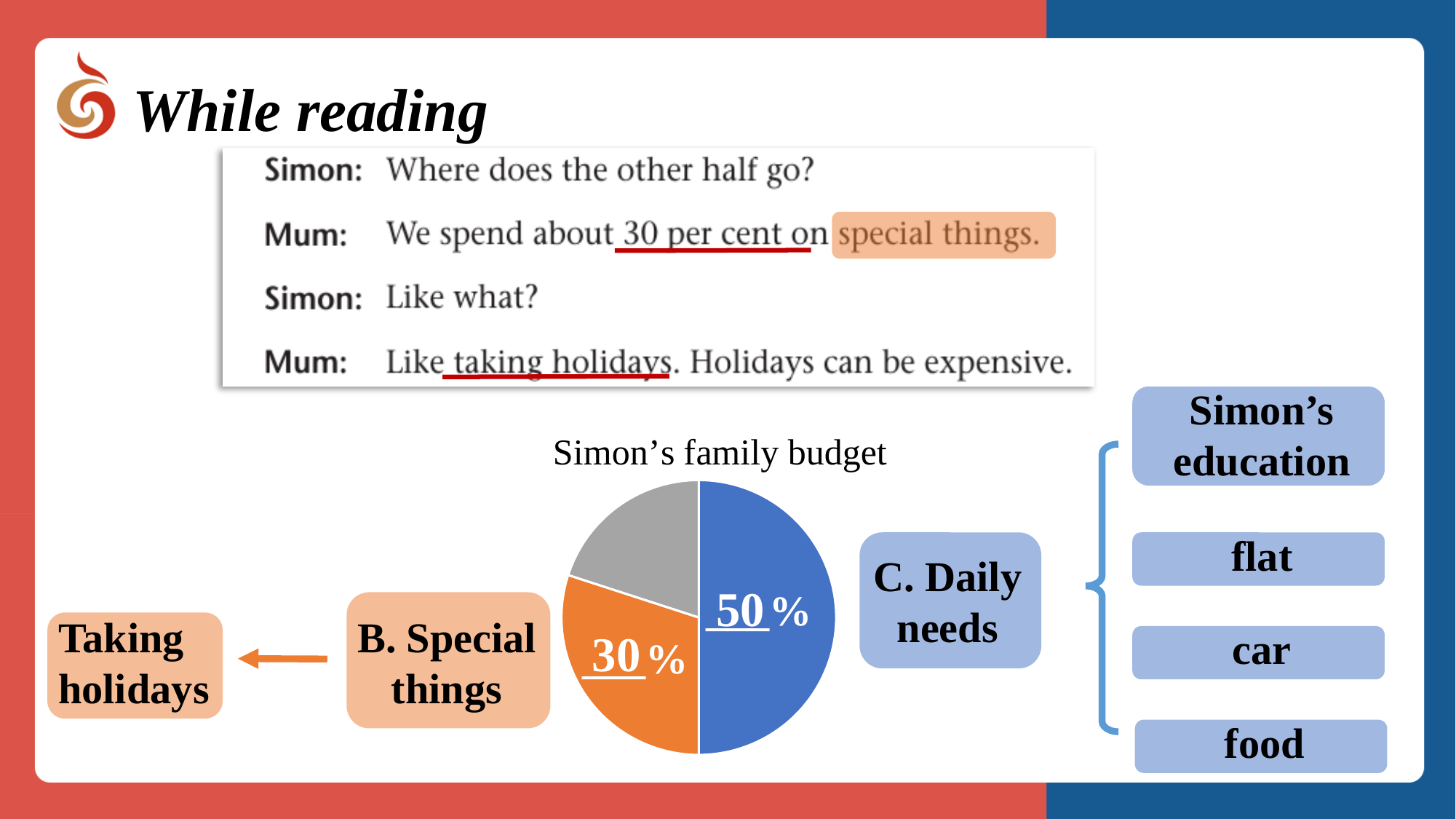
What kind of chart is shown on the slide? pie chart What percentage of Simon's family budget goes to special things? 30% What share of the pie does daily needs represent? 50% What percentage of Simon's family budget goes to daily needs? 50% Which is larger in Simon's family budget: daily needs or special things? Daily needs What is the title of the pie chart? Simon's family budget How many slices does the pie chart have? 3 What colour is the slice representing special things? orange Which labelled category takes the largest share of Simon's family budget? Daily needs By how many percentage points does the daily needs share exceed the special things share? 20 percentage points